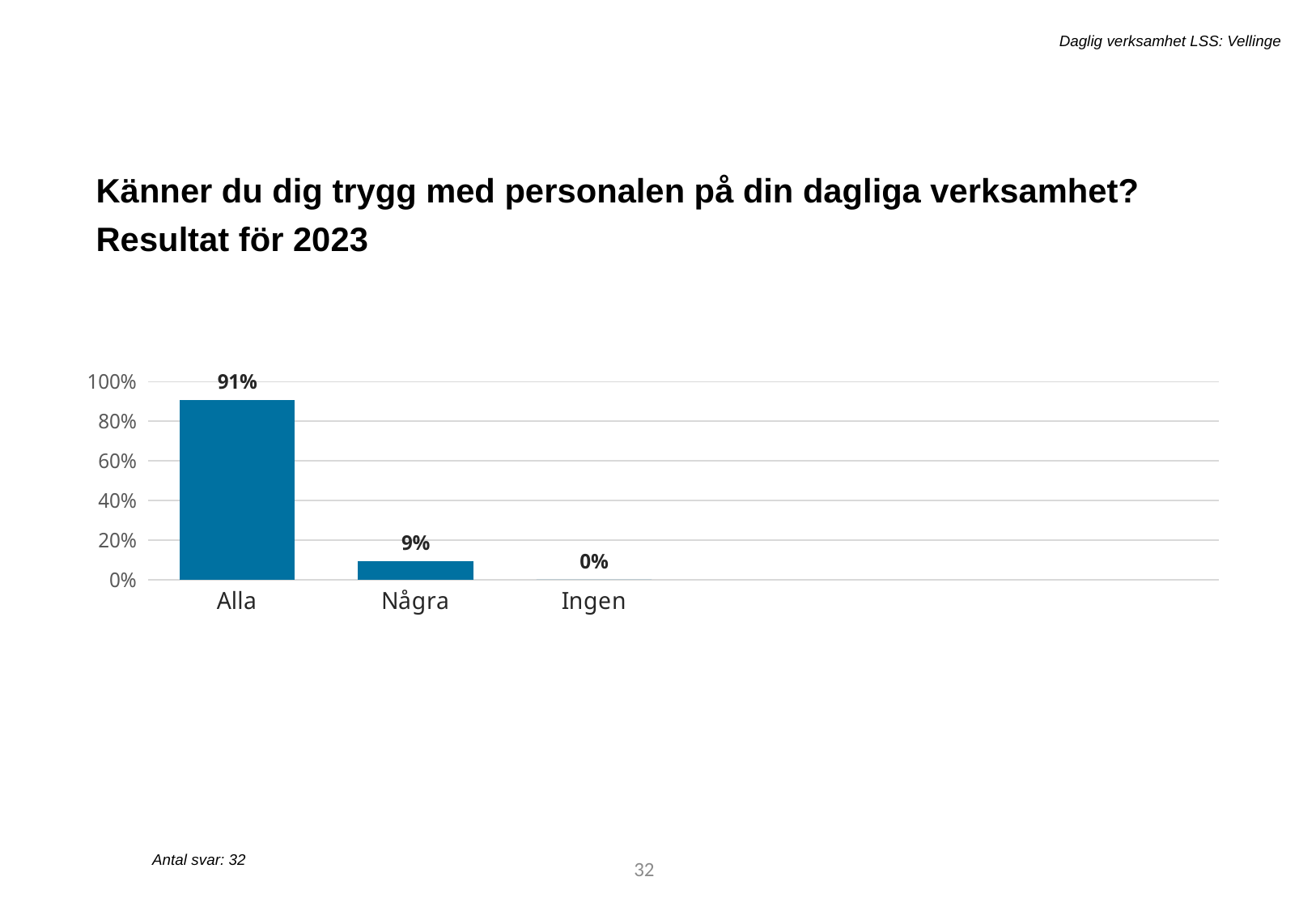
What is the difference between the values for Alla and Några? 82% Which category has the highest value? Alla Is the value for Alla greater or less than 80%? greater What is the value for Alla? 91% What is the value for Ingen? 0% How many responses (Antal svar) does the slide report? 32 Do the values rise or fall from left to right along the x axis? fall Which category has the lowest value? Ingen How many categories are shown on the x axis? 3 What is the value for Några? 9% What kind of chart is shown on the slide? bar chart Which is larger, the value for Några or the value for Ingen? Några